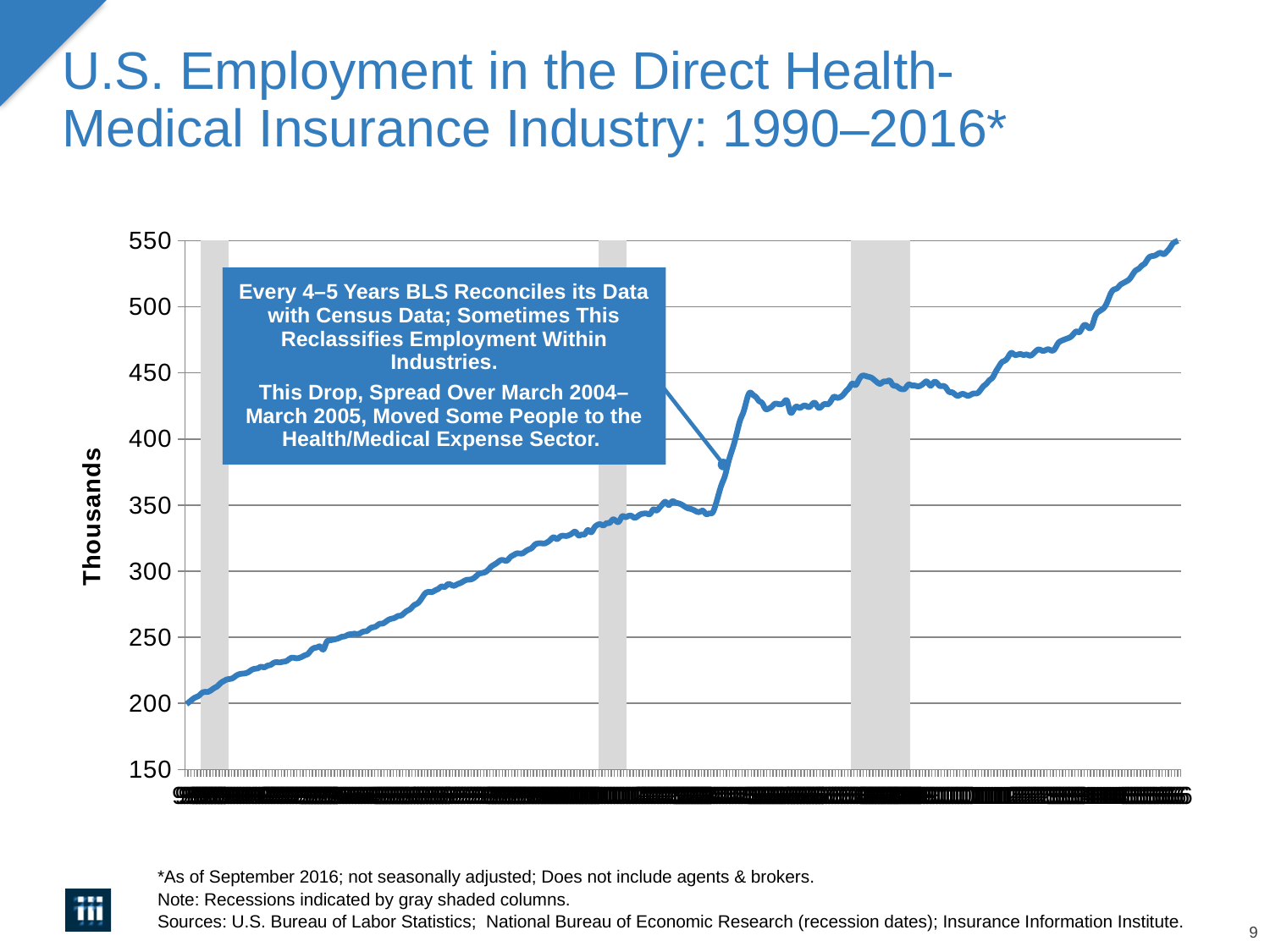
Is the value at the start of the series (1990) greater or less than 250? less What kind of chart is shown on the slide? line chart What is the label on the y axis? Thousands Overall, do the values rise or fall from the left of the x axis to the right? rise Is the value at the end of the series (2016) greater or less than 500? greater What is the highest value shown on the y axis? 550 Is the value immediately after the sharp jump that follows the March 2004–March 2005 drop greater or less than 400? greater